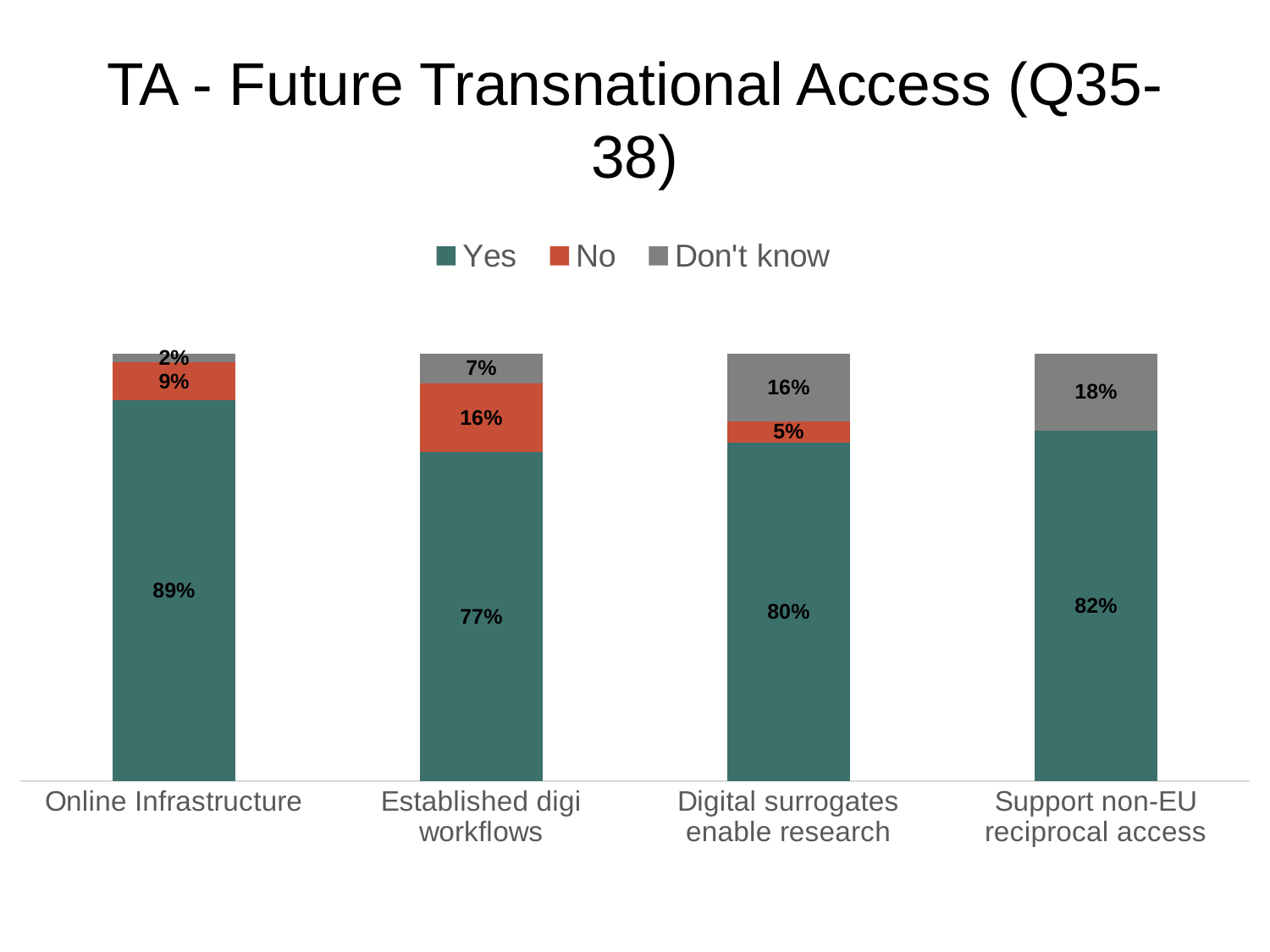
Which series is shown in red in the legend? No Which is larger: the No percentage for Online Infrastructure or the No percentage for Digital surrogates enable research? Online Infrastructure Which category has the lowest Yes percentage? Established digi workflows What percentage answered No for Established digi workflows? 16% Which category has the highest Yes percentage? Online Infrastructure What is the difference between the Yes percentage for Online Infrastructure and the Yes percentage for Established digi workflows? 12% What percentage answered Don't know for Digital surrogates enable research? 16% How many categories are shown on the x axis? 4 What percentage answered Don't know for Support non-EU reciprocal access? 18% How many series does the legend list? 3 What kind of chart is shown on the slide? Stacked bar chart What percentage answered Yes for Online Infrastructure? 89%